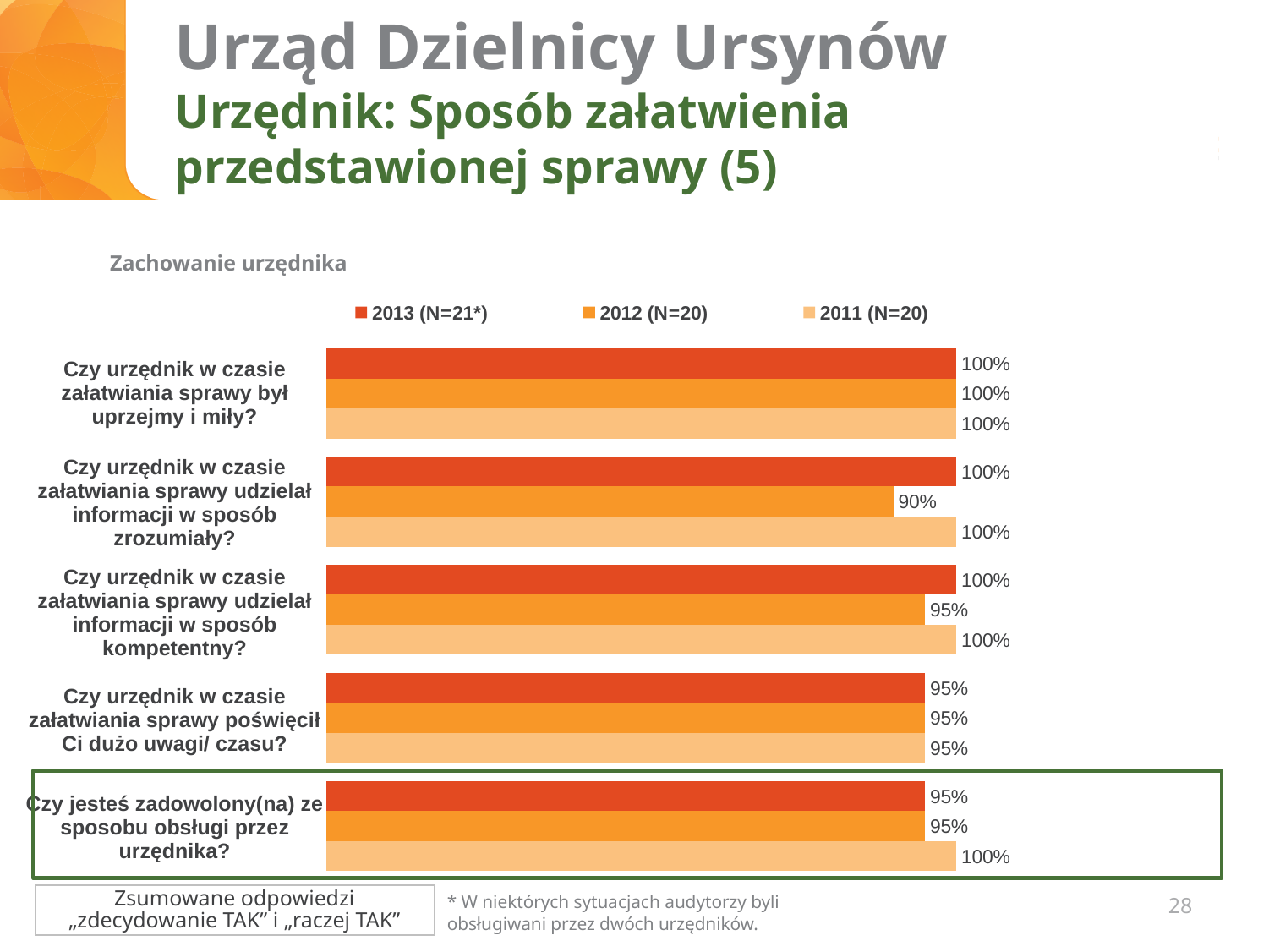
What is the 2012 (N=20) value for "Czy urzędnik w czasie załatwiania sprawy udzielał informacji w sposób kompetentny?"? 95% What is the 2011 (N=20) value for "Czy urzędnik w czasie załatwiania sprawy poświęcił Ci dużo uwagi/ czasu?"? 95% What is the 2013 (N=21*) value for "Czy jesteś zadowolony(na) ze sposobu obsługi przez urzędnika?"? 95% How many series does the legend list? 3 What is the difference between the 2011 (N=20) and 2012 (N=20) values for "Czy urzędnik w czasie załatwiania sprawy udzielał informacji w sposób kompetentny?"? 5% What is the 2012 (N=20) value for "Czy urzędnik w czasie załatwiania sprawy udzielał informacji w sposób zrozumiały?"? 90% What is the difference between the 2013 (N=21*) and 2012 (N=20) values for "Czy urzędnik w czasie załatwiania sprawy udzielał informacji w sposób zrozumiały?"? 10% What is the title shown above the chart? Zachowanie urzędnika Which series has the lowest value for "Czy urzędnik w czasie załatwiania sprawy udzielał informacji w sposób zrozumiały?"? 2012 (N=20) What type of chart is shown on the slide? bar chart How many question categories are plotted on the chart? 5 For "Czy jesteś zadowolony(na) ze sposobu obsługi przez urzędnika?", which is larger: the 2011 (N=20) value or the 2013 (N=21*) value? 2011 (N=20)